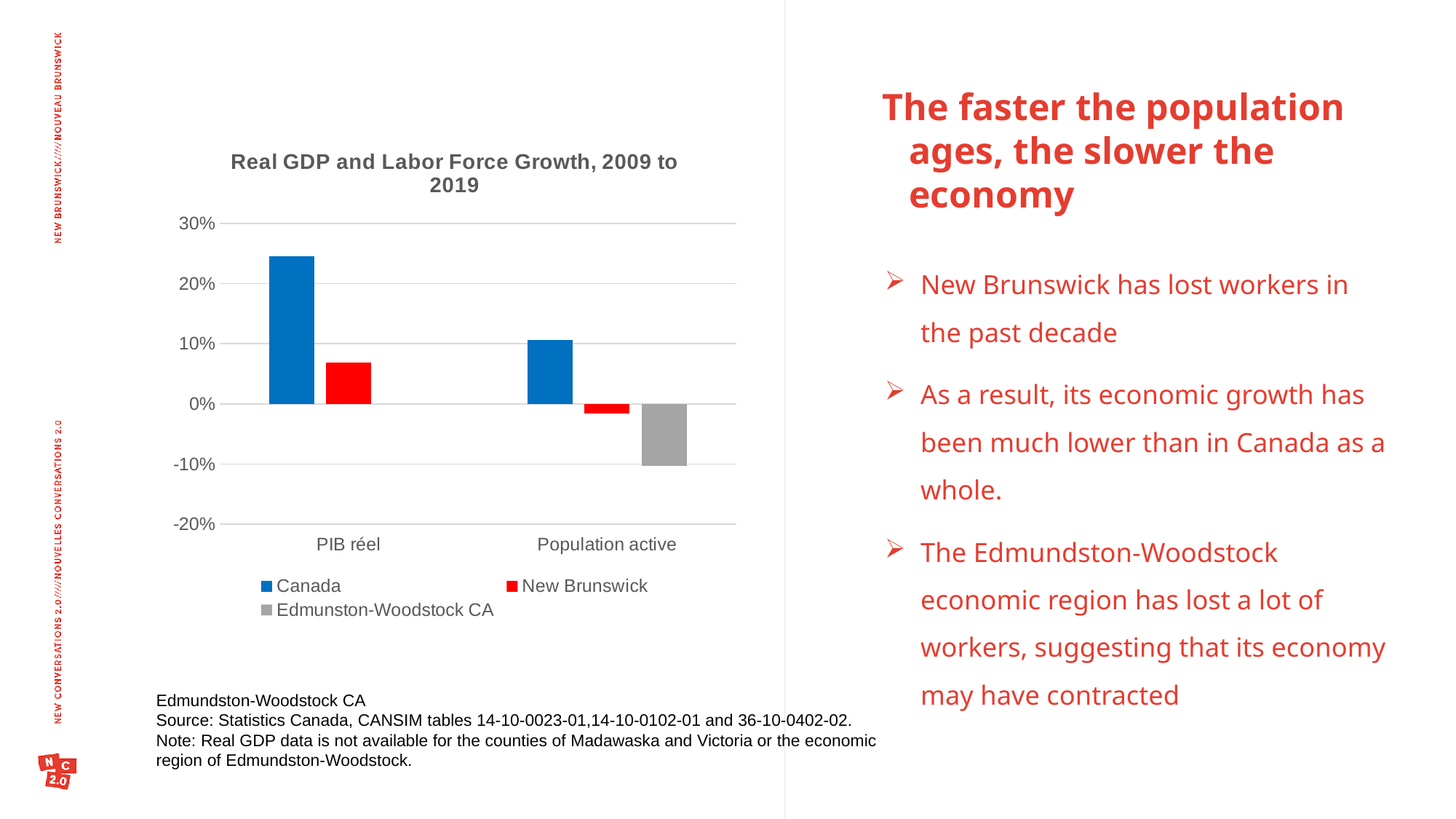
In the PIB réel category, which is larger: Canada or New Brunswick? Canada How many categories are shown on the x axis of the chart? 2 Is the value for New Brunswick in the PIB réel category greater or less than 10%? less What is the title of the chart? Real GDP and Labor Force Growth, 2009 to 2019 How many series does the chart legend list? 3 Is the value for Canada in the PIB réel category greater or less than 20%? greater Which series has the highest bar in the chart? Canada What kind of chart is shown on the slide? bar chart Which series has the lowest bar in the Population active category? Edmunston-Woodstock CA Which series is shown in red in the chart? New Brunswick Is the value for Edmunston-Woodstock CA in the Population active category greater or less than 0%? less